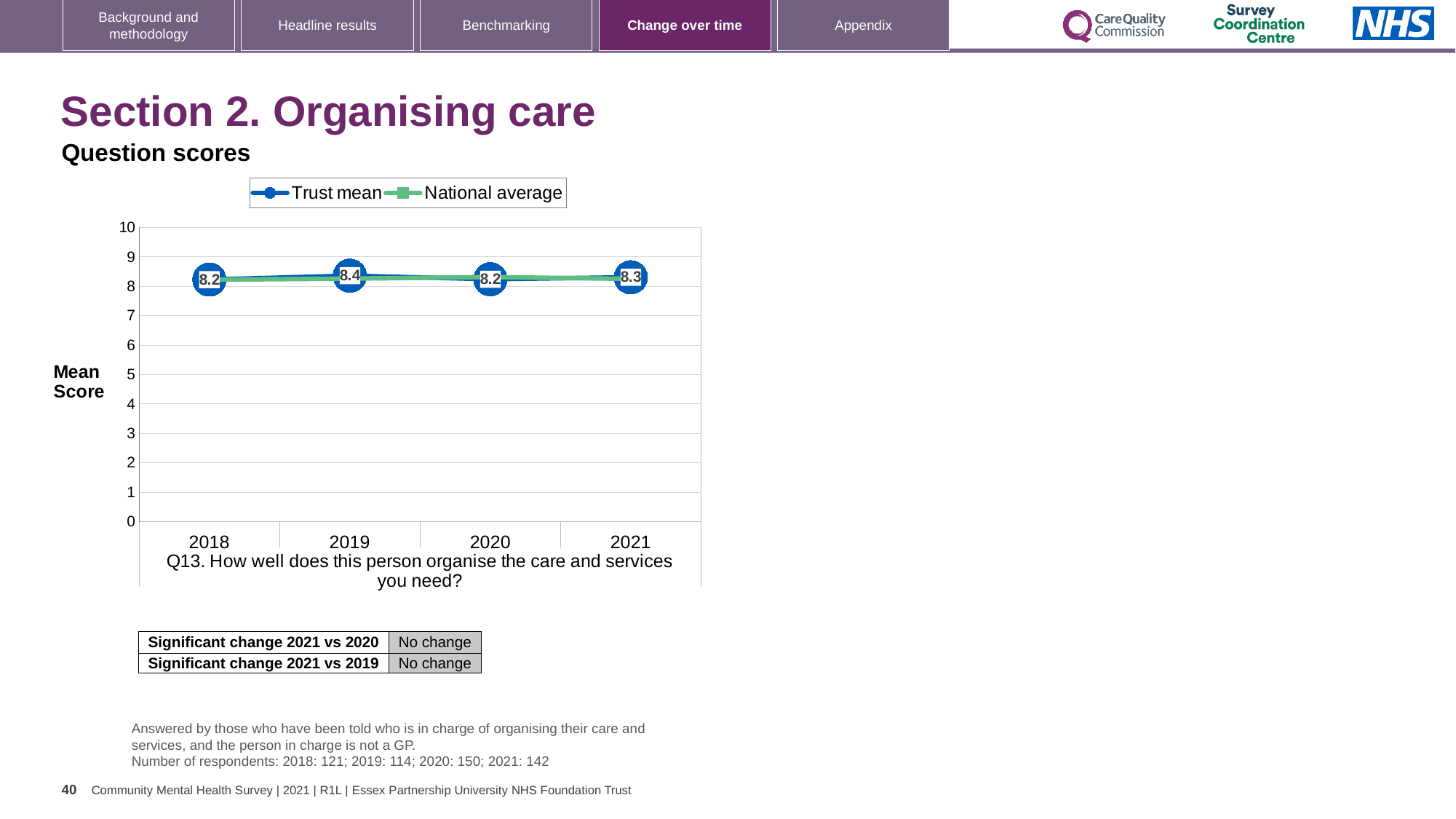
What is the Trust mean for 2018? 8.2 Which year has the larger Trust mean, 2020 or 2021? 2021 What kind of chart is shown? line chart Is the National average for 2021 greater or less than 5? greater Did the Trust mean rise or fall from 2020 to 2021? rise What is the label on the y axis? Mean Score How many years are plotted on the x axis? 4 What is the difference between the Trust mean in 2019 and in 2018? 0.2 What is the Trust mean for 2019? 8.4 How many series does the legend list? 2 What is the Trust mean for 2021? 8.3 In which year is the Trust mean highest? 2019